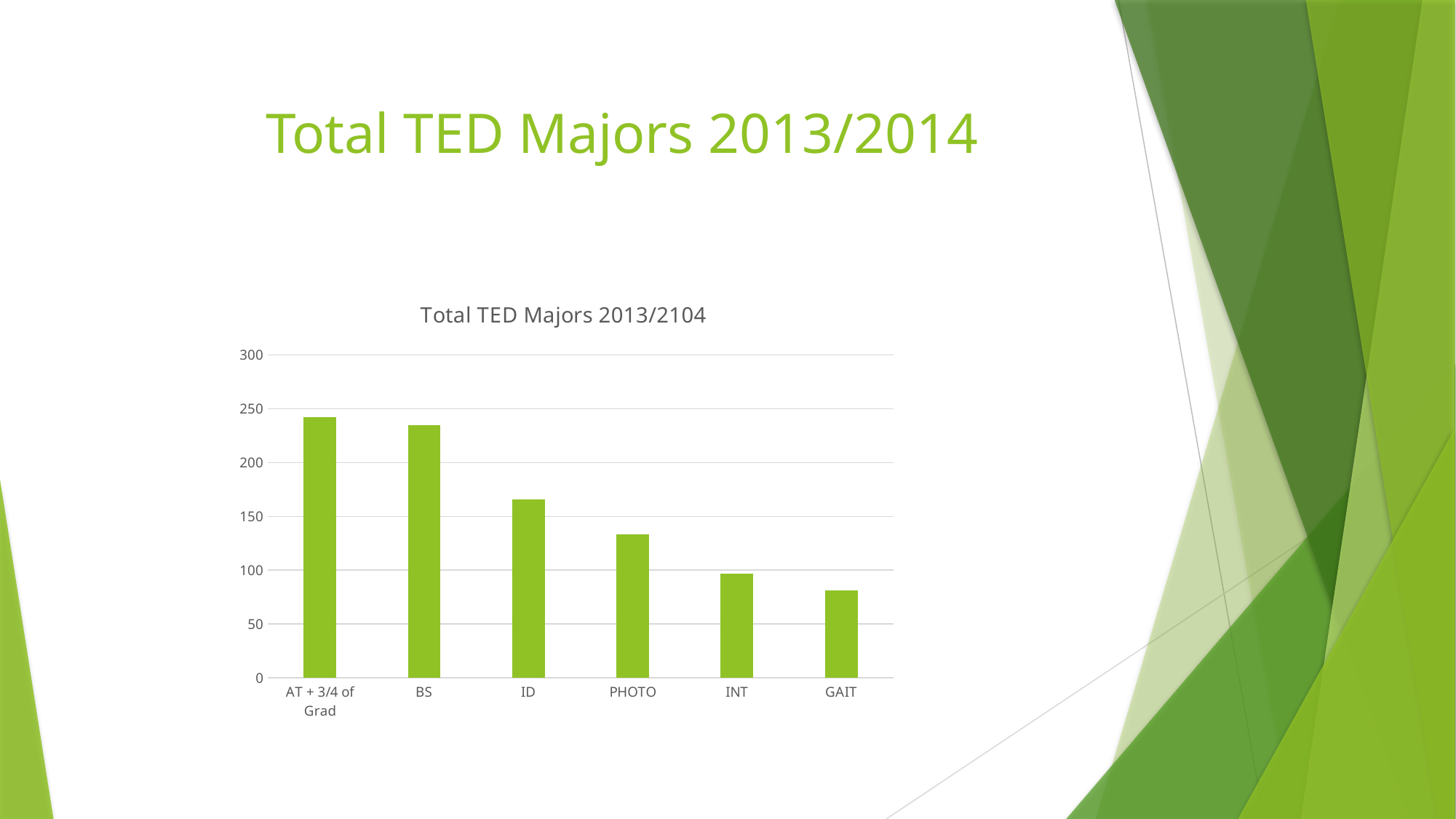
Is the value for BS greater or less than 200? greater Do the values rise or fall from left to right across the categories? fall Is the value for ID greater or less than 150? greater What is the title printed on the chart? Total TED Majors 2013/2104 What kind of chart is shown on the slide? bar chart Is the value for PHOTO greater or less than 150? less Which category has the highest value? AT + 3/4 of Grad Which is larger, the value for ID or the value for PHOTO? ID Which category has the lowest value? GAIT How many categories are plotted on the chart? 6